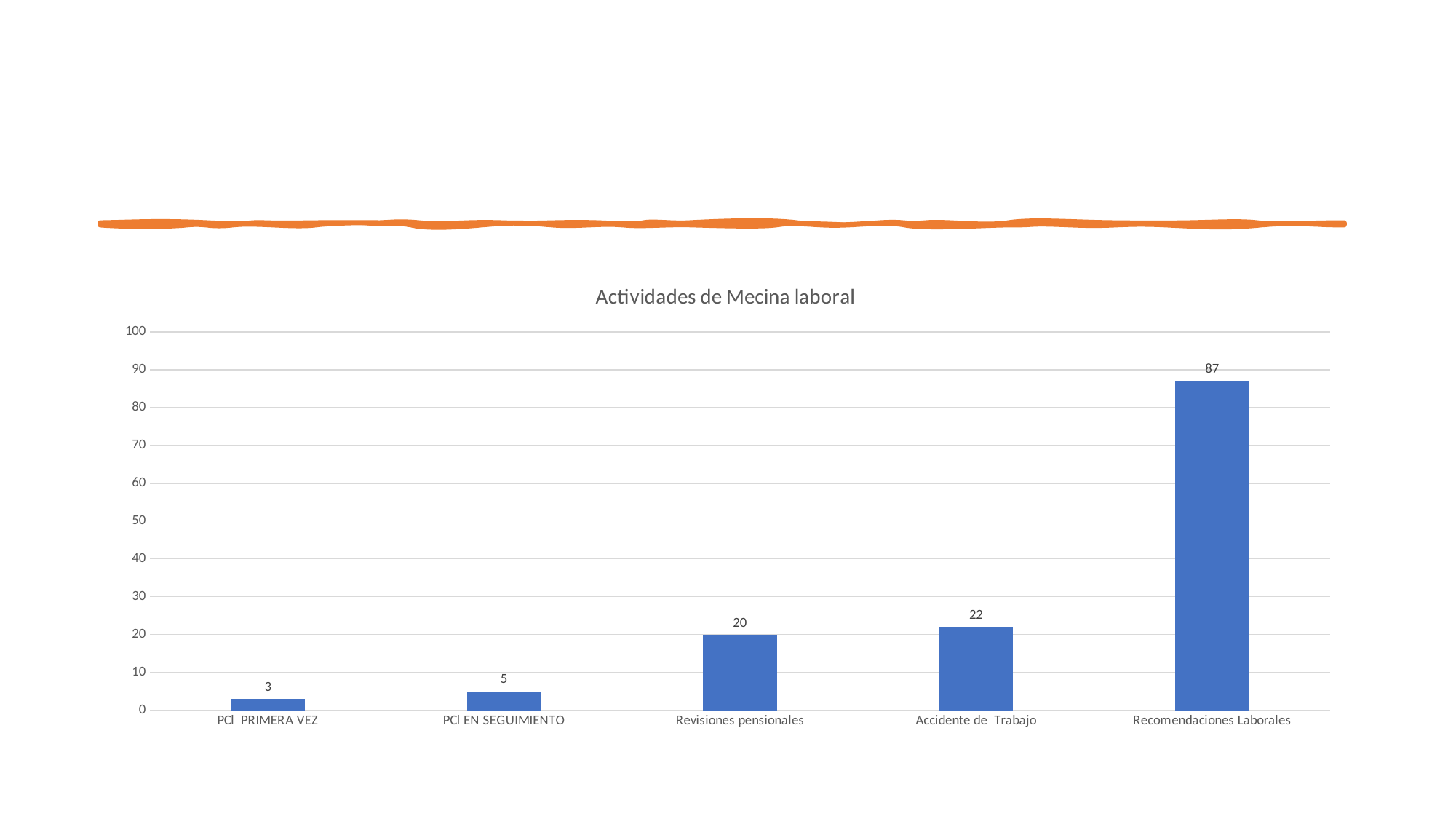
What is the value for Revisiones pensionales? 20 What is the title of the chart? Actividades de Mecina laboral What is the value for Recomendaciones Laborales? 87 What is the difference between the values for Recomendaciones Laborales and Accidente de Trabajo? 65 What kind of chart is shown on the slide? bar chart What is the value for PCl EN SEGUIMIENTO? 5 Is the value for Recomendaciones Laborales greater or less than 80? greater How many categories are shown on the x axis? 5 Which is larger, the value for Accidente de Trabajo or the value for PCl EN SEGUIMIENTO? Accidente de Trabajo Which category has the lowest value? PCl PRIMERA VEZ Which category has the highest value? Recomendaciones Laborales What is the difference between the values for Accidente de Trabajo and Revisiones pensionales? 2